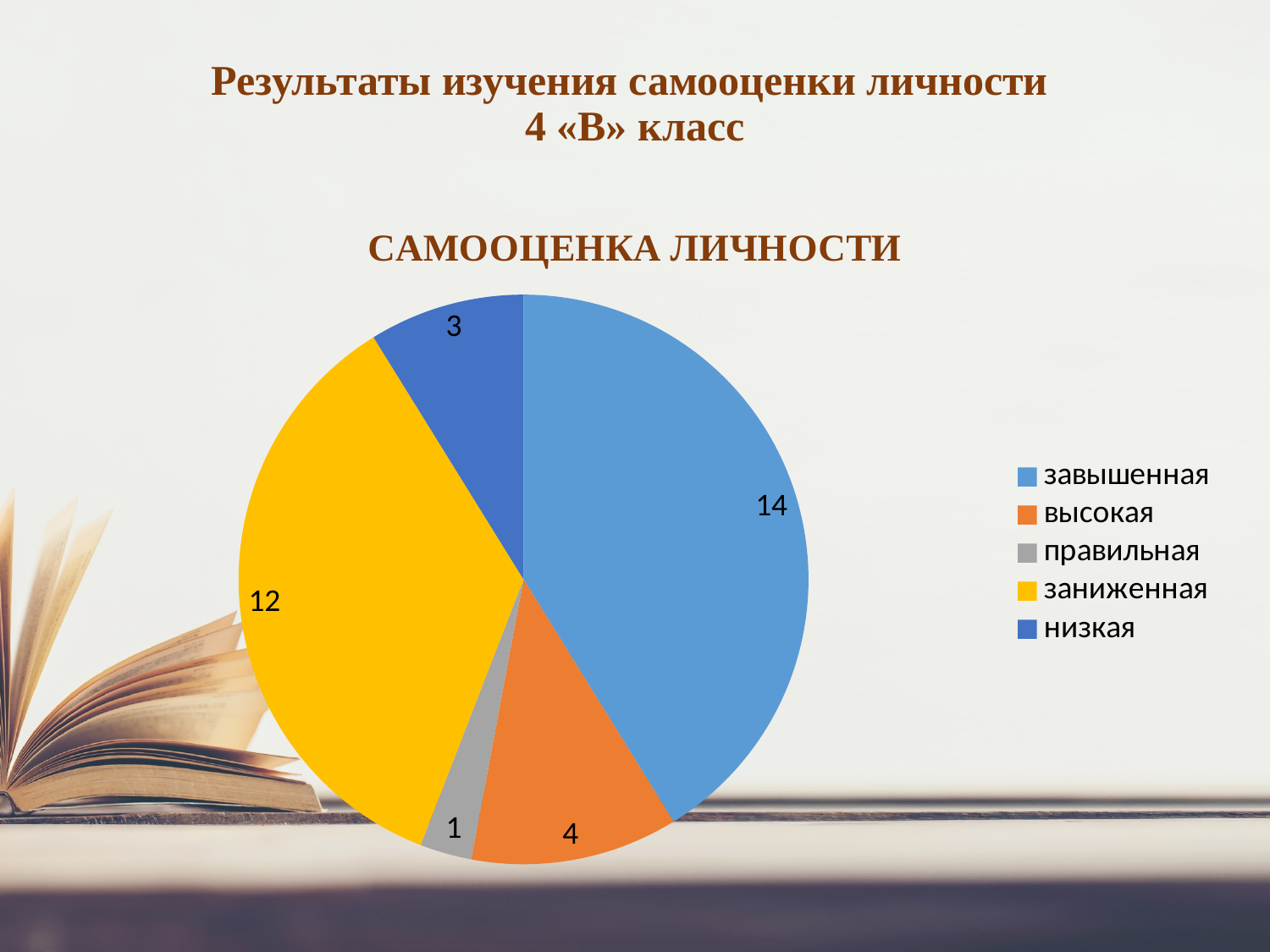
What is the total of all slices in the pie chart? 34 What is the title of the chart? САМООЦЕНКА ЛИЧНОСТИ What is the value for завышенная? 14 Which category has the largest slice? завышенная What is the value for низкая? 3 What is the value for заниженная? 12 What is the difference between the values for завышенная and заниженная? 2 What type of chart is shown on the slide? pie chart What is the value for высокая? 4 How many categories does the pie chart have? 5 Which category has the smallest slice? правильная Which is larger, the value for высокая or the value for низкая? высокая